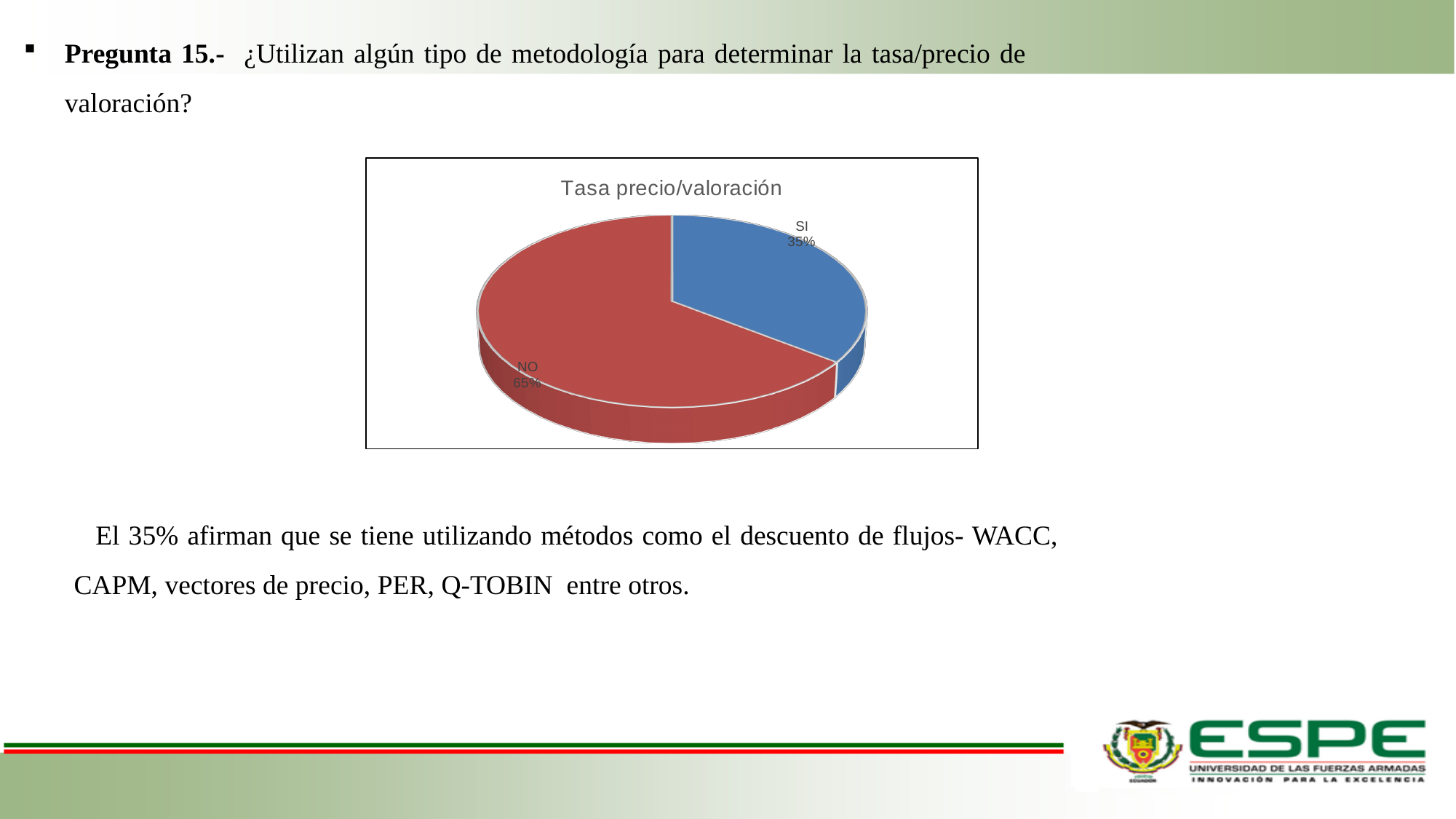
What is the difference in percentage points between the NO slice and the SI slice? 30% Which is larger, the SI slice or the NO slice? NO What share of the pie does the SI slice represent? 35% Which slice is the smallest in the pie chart? SI What is the title of the chart? Tasa precio/valoración What colour is the NO slice? red What kind of chart is shown on the slide? pie chart How many slices does the pie chart have? 2 Which slice is the largest in the pie chart? NO What share of the pie does the NO slice represent? 65%